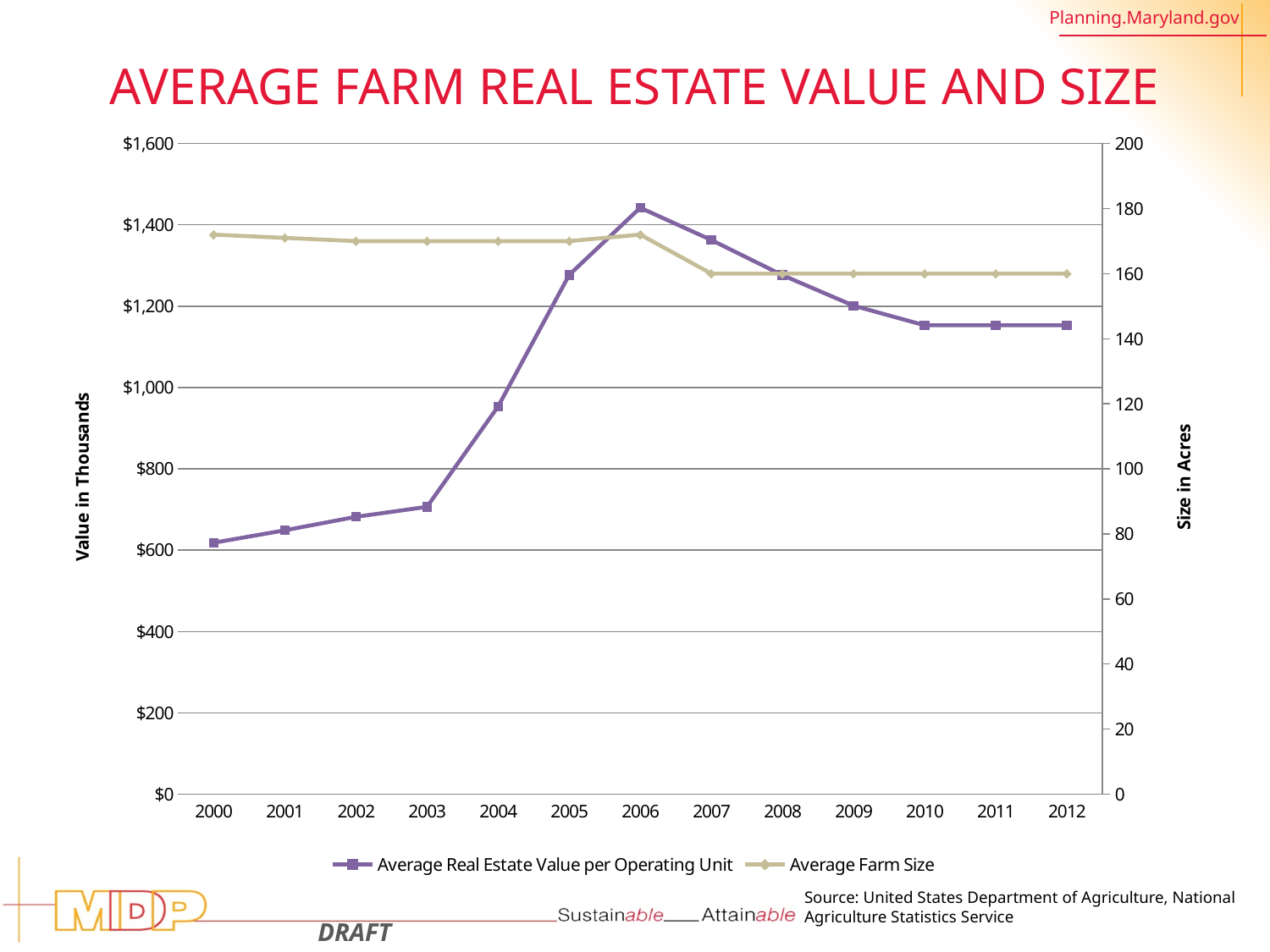
Is the Average Real Estate Value per Operating Unit in 2006 greater or less than $1,400? greater Is the Average Real Estate Value per Operating Unit in 2000 greater or less than $800? less In which year is the Average Real Estate Value per Operating Unit highest? 2006 What is the title of the right-hand vertical axis? Size in Acres Which is larger, the Average Real Estate Value per Operating Unit in 2006 or in 2012? 2006 Is the Average Real Estate Value per Operating Unit in 2010 greater or less than $1,200? less What kind of chart is shown on the slide? line chart In which year is the Average Real Estate Value per Operating Unit lowest? 2000 How many series does the legend list? 2 Does the Average Real Estate Value per Operating Unit rise or fall from 2000 to 2006? rise How many years are plotted along the x axis? 13